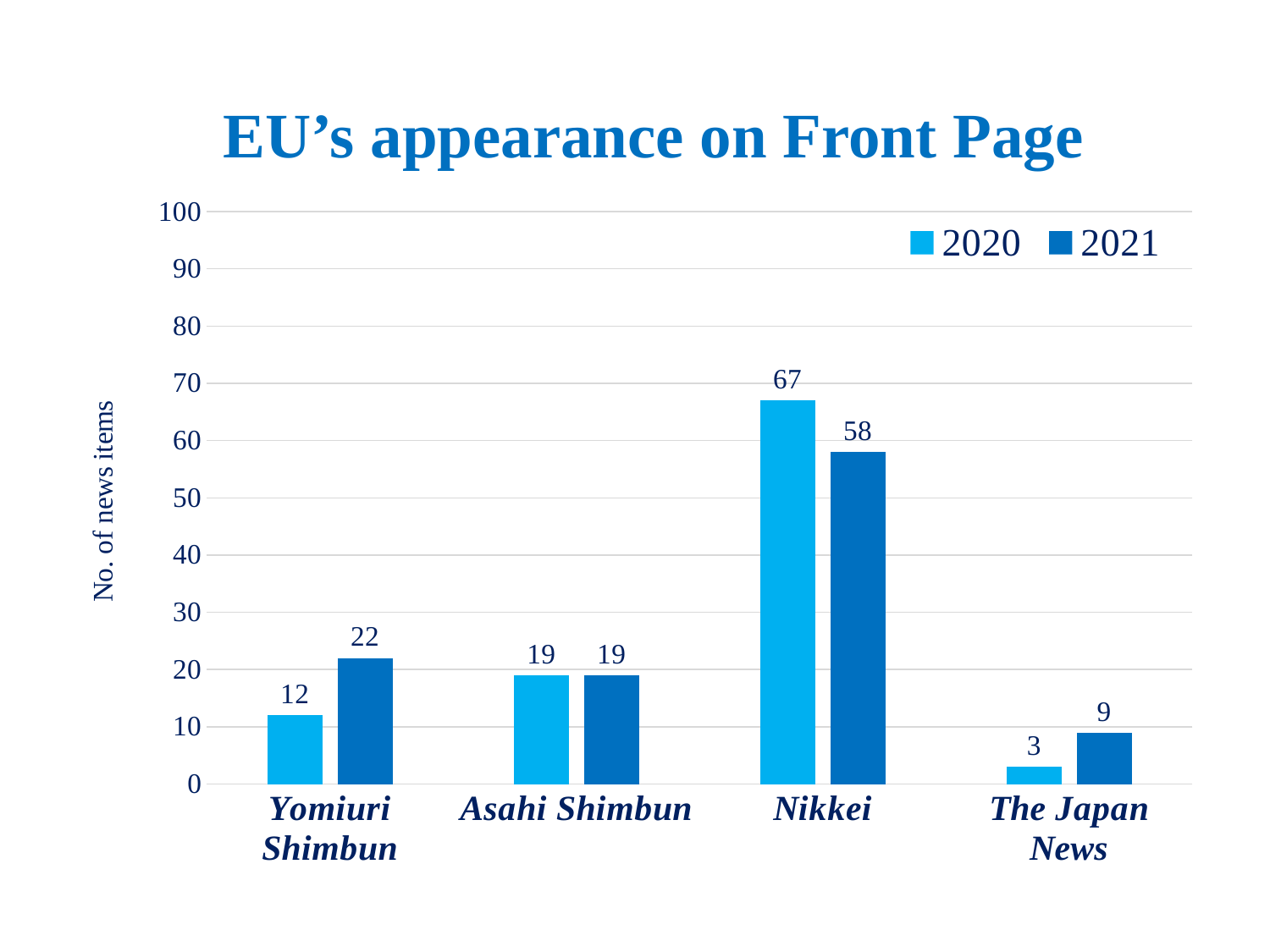
What is the 2021 value for Yomiuri Shimbun? 22 What is the 2020 value for The Japan News? 3 Which is larger for Yomiuri Shimbun, the 2020 value or the 2021 value? 2021 What is the difference between the 2020 and 2021 values for Nikkei? 9 What is the 2020 value for Nikkei? 67 Which newspaper has the highest 2021 value? Nikkei Is the 2021 value for Nikkei greater or less than 50? greater How many newspapers are shown on the x axis? 4 How many series does the legend list? 2 What kind of chart is shown on the slide? bar chart Which newspaper has the lowest 2020 value? The Japan News What is the title of the chart? EU's appearance on Front Page